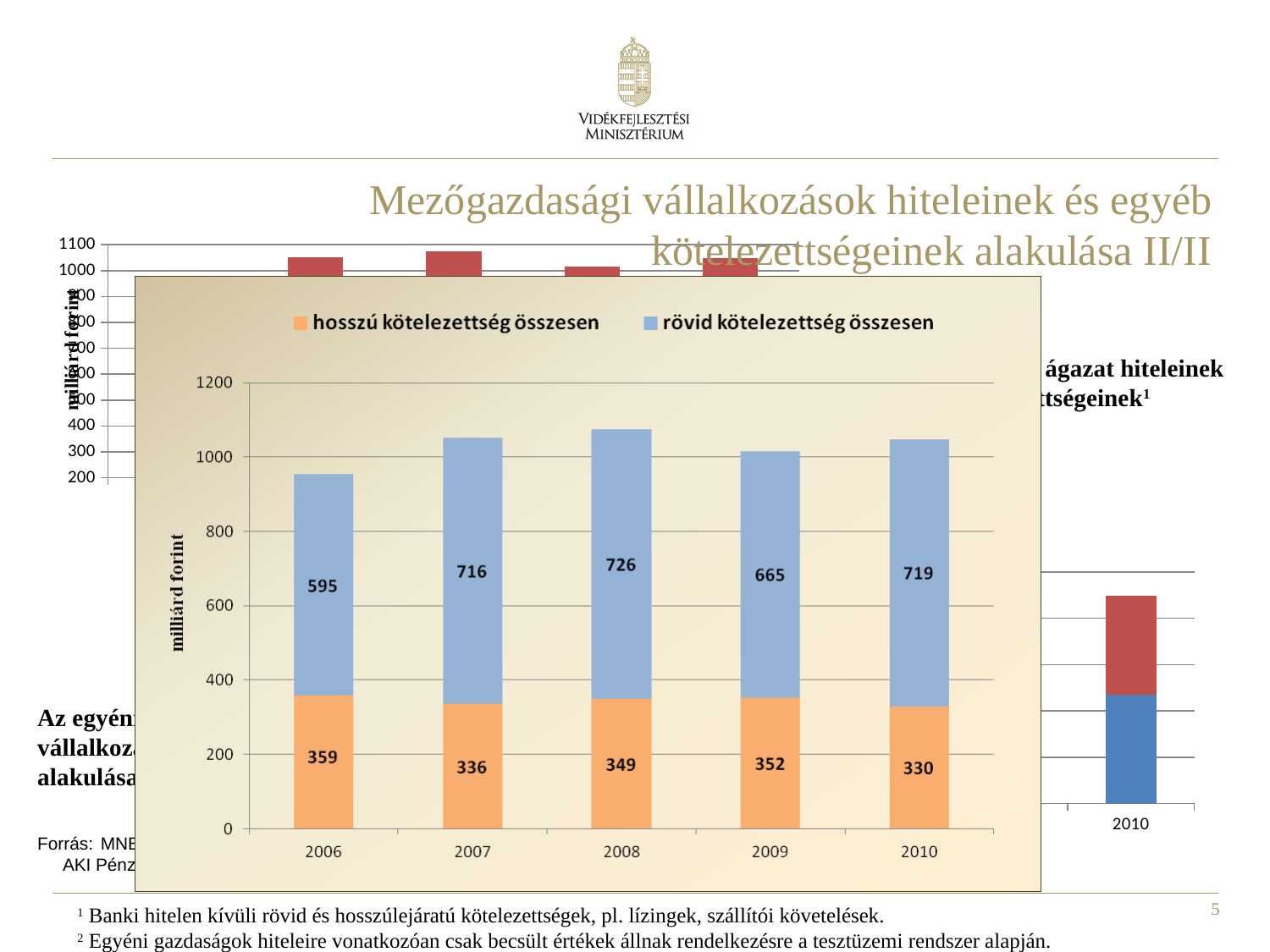
In the front stacked bar chart (hosszú/rövid kötelezettség összesen), what is the value of hosszú kötelezettség összesen for 2010? 330 In the front stacked bar chart (hosszú/rövid kötelezettség összesen), how many series does the legend list? 2 In the front stacked bar chart (hosszú/rövid kötelezettség összesen), how many years are shown on the x axis? 5 In the front stacked bar chart (hosszú/rövid kötelezettség összesen), what is the total of the stacked bar for 2008? 1075 In the front stacked bar chart (hosszú/rövid kötelezettség összesen), which year has the highest value for rövid kötelezettség összesen? 2008 In the front stacked bar chart (hosszú/rövid kötelezettség összesen), what is the total of the stacked bar for 2006? 954 In the front stacked bar chart (hosszú/rövid kötelezettség összesen), what is the value of hosszú kötelezettség összesen for 2006? 359 In the front stacked bar chart (hosszú/rövid kötelezettség összesen), which year has the lowest value for hosszú kötelezettség összesen? 2010 In the front stacked bar chart (hosszú/rövid kötelezettség összesen), is rövid kötelezettség összesen larger in 2009 or in 2010? 2010 In the front stacked bar chart (hosszú/rövid kötelezettség összesen), what is the value of rövid kötelezettség összesen for 2008? 726 In the front stacked bar chart (hosszú/rövid kötelezettség összesen), what is the label of the vertical axis? milliárd forint In the front stacked bar chart (hosszú/rövid kötelezettség összesen), what is the difference between rövid kötelezettség összesen in 2007 and in 2006? 121